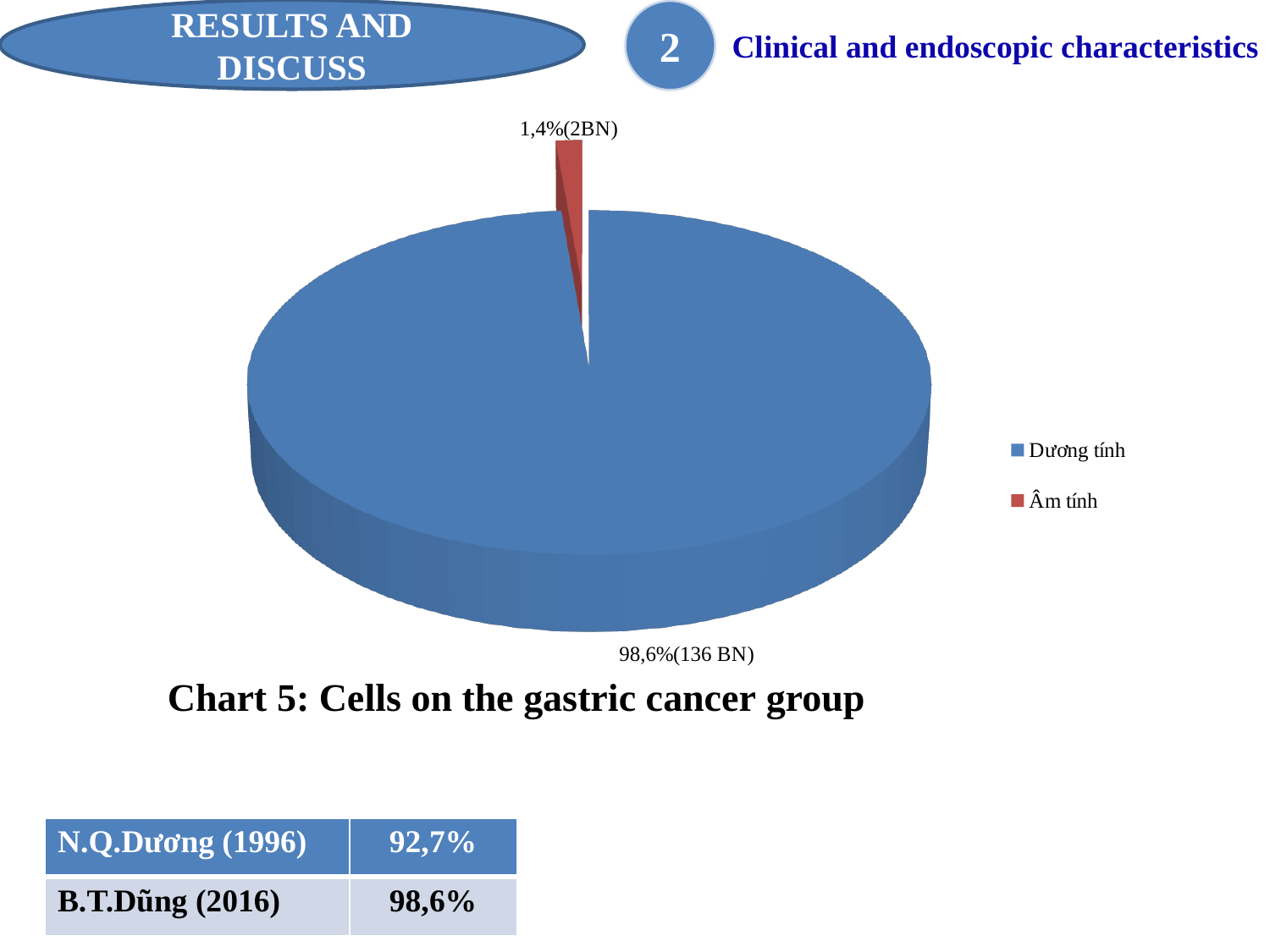
What is the share of the pie for Dương tính? 98,6% What is the title of the chart? Chart 5: Cells on the gastric cancer group Which slice of the pie is the largest? Dương tính Which is larger, the Dương tính slice or the Âm tính slice? Dương tính Which slice of the pie is the smallest? Âm tính What kind of chart is shown on the slide? pie chart How many slices does the pie chart have? 2 What is the difference in percentage points between the Dương tính and Âm tính slices? 97,2 How many patients (BN) are in the Dương tính slice? 136 BN What is the share of the pie for Âm tính? 1,4% How many entries does the legend list? 2 How many patients (BN) are in the Âm tính slice? 2BN